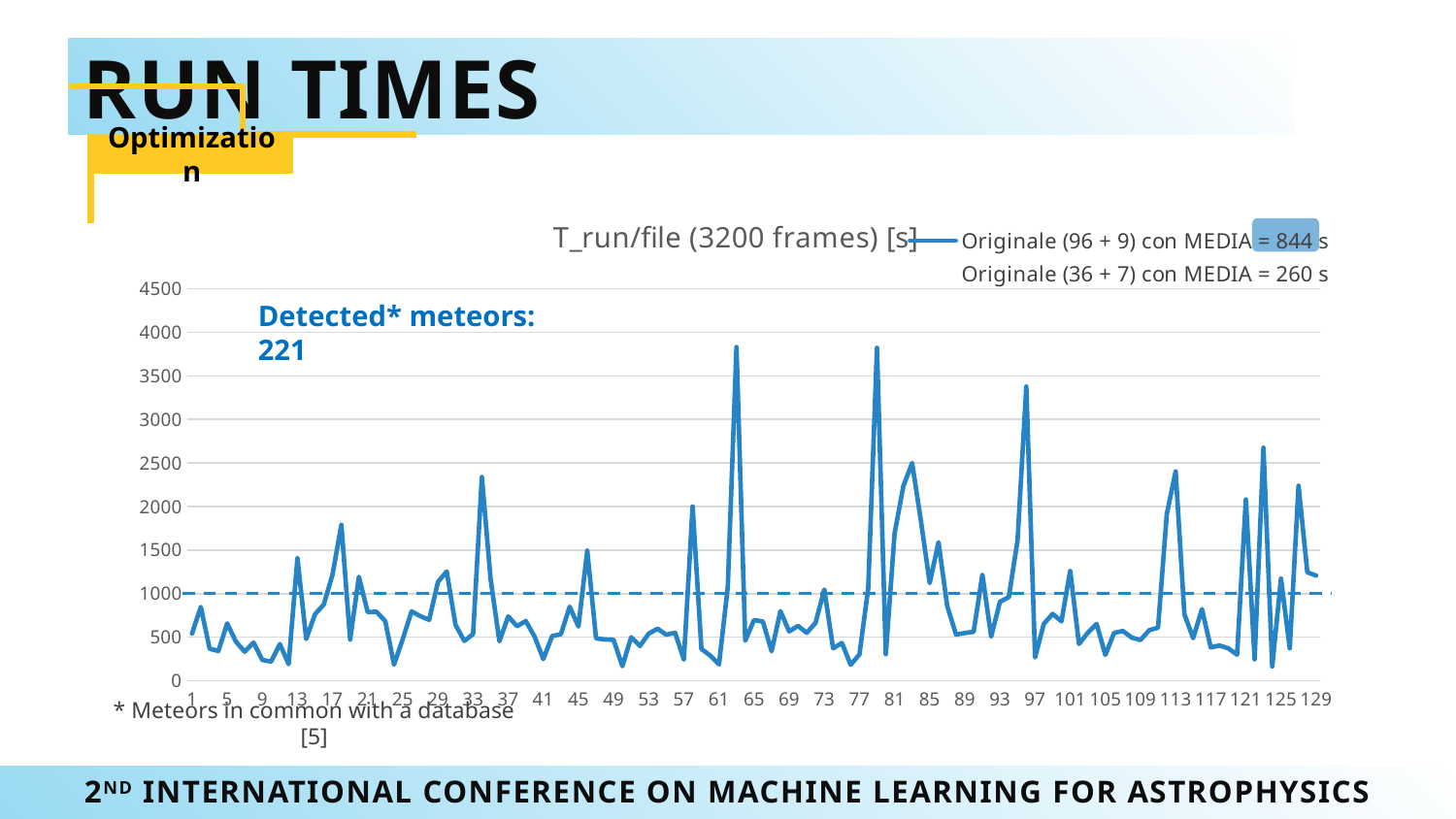
Is the value at x = 63 greater or less than 3500? greater What is the title of the chart? T_run/file (3200 frames) [s] What is the highest value shown on the y axis? 4500 What is the first series name listed in the chart legend? Originale (96 + 9) con MEDIA = 844 s How many series does the chart legend list? 2 What kind of chart is shown on the slide? line chart Is the value at x = 1 greater or less than 1000? less Is the value at x = 79 greater or less than 3000? greater Is the value at x = 63 larger or smaller than the value at x = 65? larger